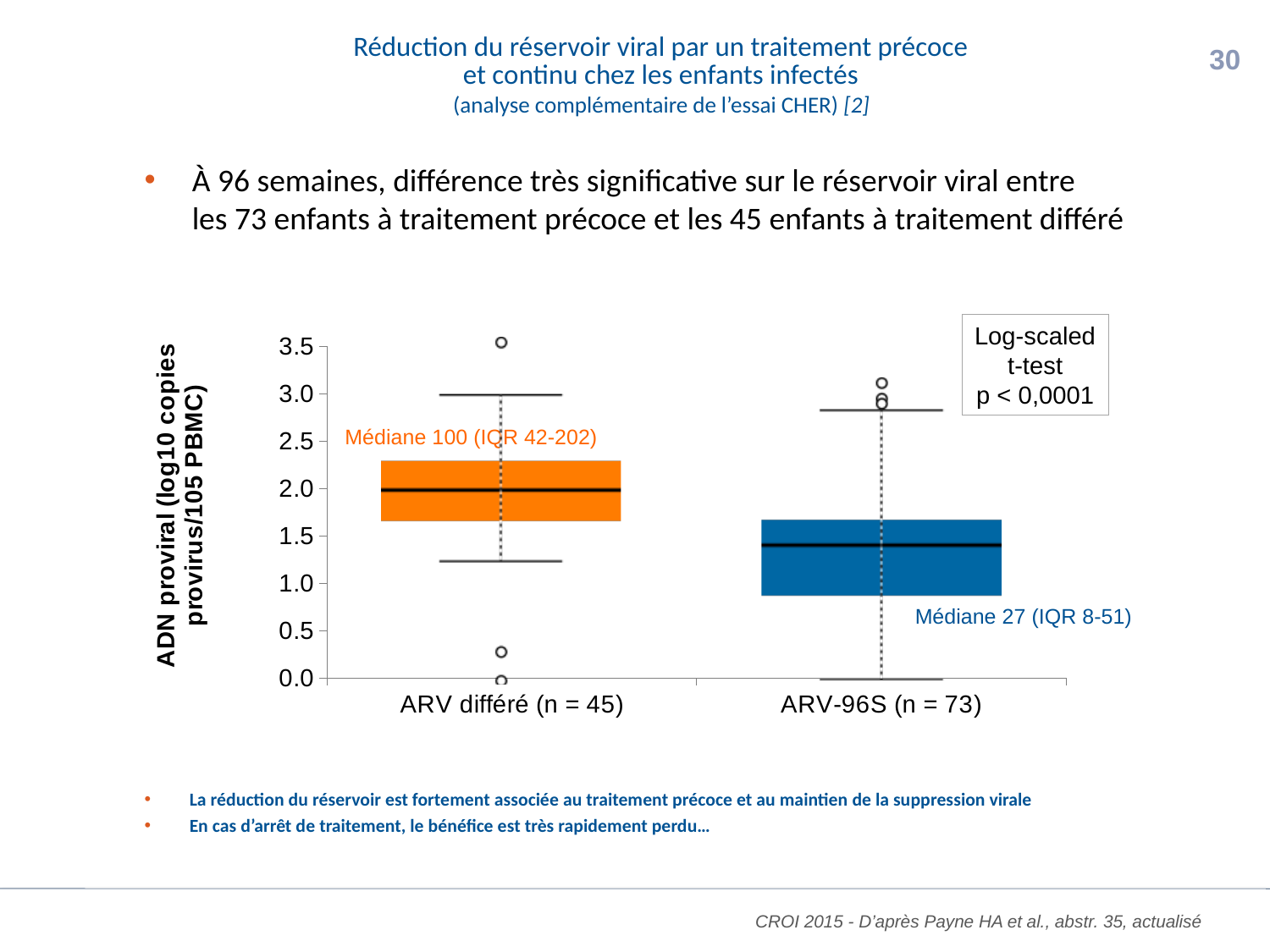
Is the median line of the ARV différé box greater or less than 1.5 on the y axis? greater What median value is annotated for the ARV différé group? Médiane 100 (IQR 42-202) Which group has the lowest annotated median proviral DNA? ARV-96S What kind of chart is shown on the slide? Box plot Is the median line of the ARV-96S box greater or less than 2.0 on the y axis? less What p-value is shown in the text box on the chart? p < 0,0001 What median value is annotated for the ARV-96S group? Médiane 27 (IQR 8-51) What colour is the box for the ARV différé group? Orange Which group has the higher annotated median proviral DNA? ARV différé How many children are in the ARV-96S group according to the x-axis label? 73 How many groups are plotted on the x axis of the chart? 2 What is the IQR annotated for the ARV-96S group? 8-51